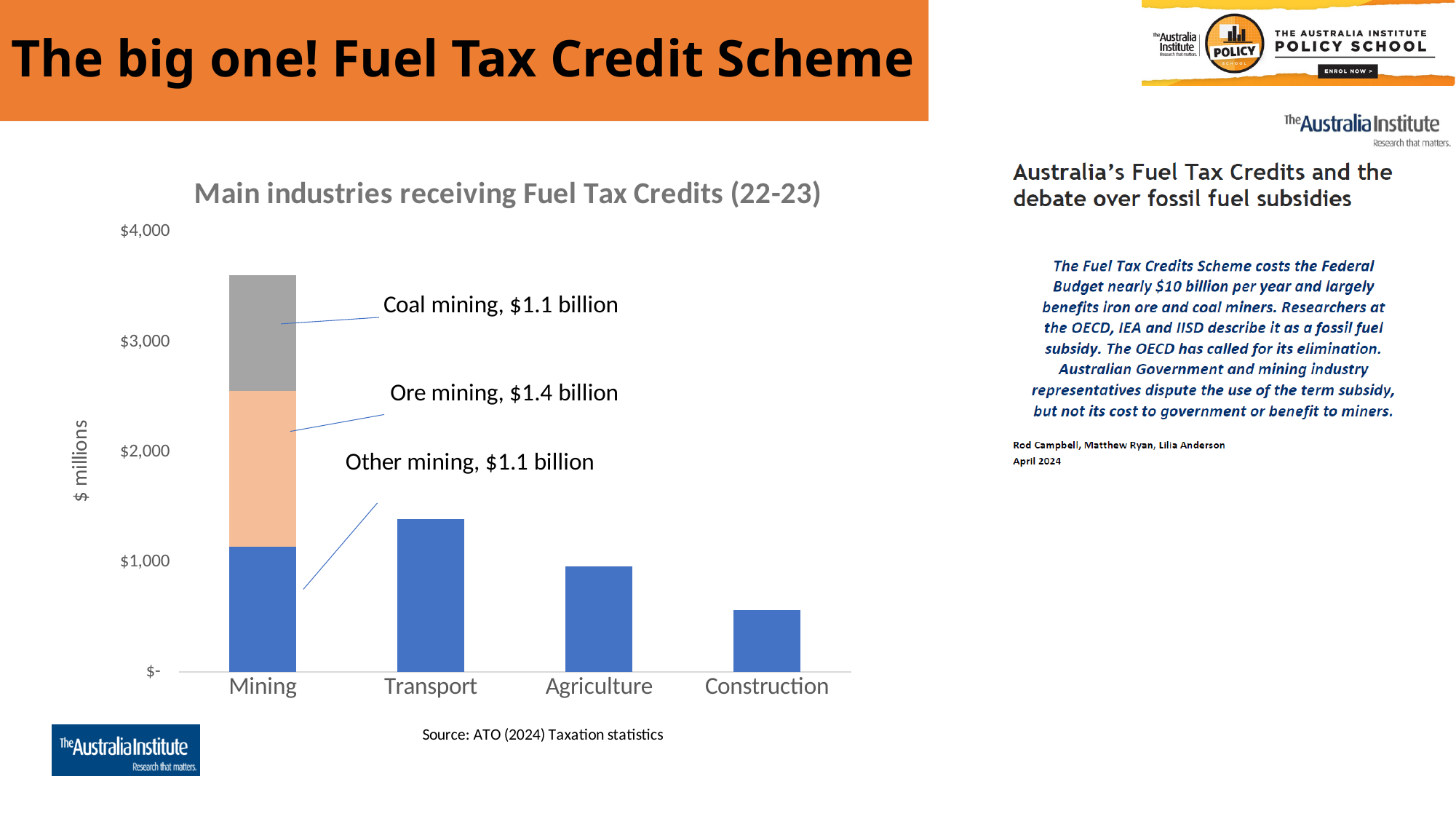
What value is labelled for Coal mining in the chart? $1.1 billion Which industry receives the most Fuel Tax Credits in the chart? Mining Which receives more Fuel Tax Credits, Transport or Agriculture? Transport What is the difference between the Ore mining and Coal mining values? $0.3 billion What is the total of the three labelled segments of the Mining bar? $3.6 billion What kind of chart is shown on the slide? Bar chart (stacked) Is the value for Transport greater or less than $2,000 million? less What is the title of the chart? Main industries receiving Fuel Tax Credits (22-23) How many industry categories are shown on the x axis of the chart? 4 What value is labelled for Ore mining in the chart? $1.4 billion What value is labelled for Other mining in the chart? $1.1 billion Which industry receives the least Fuel Tax Credits in the chart? Construction